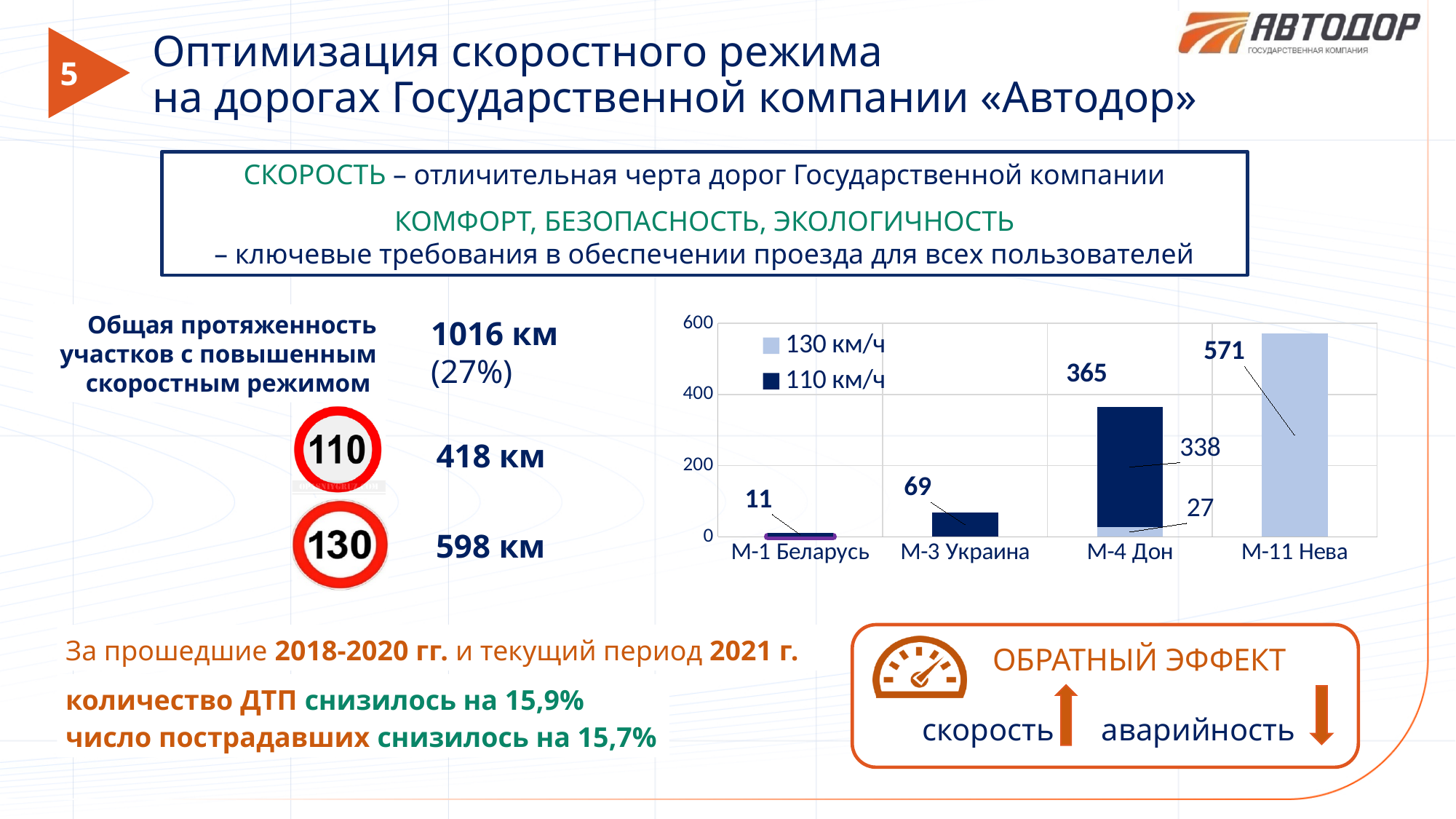
What is the total of the stacked bar for М-4 Дон? 365 What is the value for the 130 км/ч series for М-4 Дон? 27 What is the difference between the value for М-11 Нева and the total for М-4 Дон? 206 Which road has the highest bar in the chart? М-11 Нева Which road has the lowest bar in the chart? М-1 Беларусь What is the value for the 110 км/ч series for М-4 Дон? 338 What is the value labelled for М-11 Нева? 571 What kind of chart is shown on the slide? bar chart How many series does the chart legend list? 2 How many road categories are shown on the x axis of the chart? 4 Which series is shown in light blue in the chart legend? 130 км/ч What is the value labelled for М-3 Украина? 69